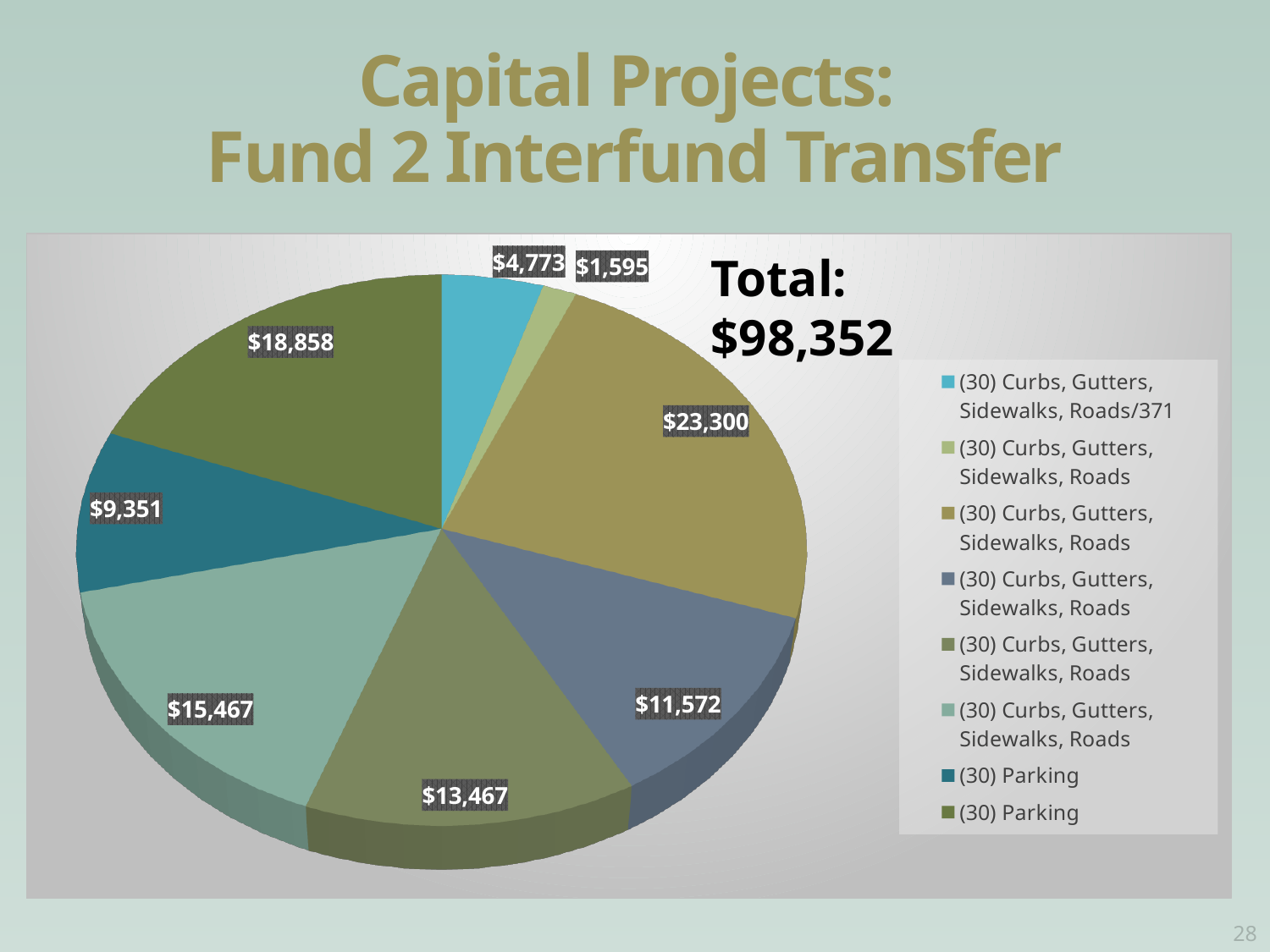
What kind of chart is shown on the slide? pie chart Which is larger, the slice labelled $18,858 or the slice labelled $15,467? $18,858 How many entries does the legend of the pie chart list? 8 How many slices does the pie chart have? 8 Which is larger, the slice labelled $11,572 or the slice labelled $13,467? $13,467 What is the difference between the $23,300 slice and the $18,858 slice? $4,442 What total is printed next to the pie chart? $98,352 What is the value of the smallest slice in the pie chart? $1,595 What is the difference between the $9,351 slice and the $4,773 slice? $4,578 What is the value for (30) Curbs, Gutters, Sidewalks, Roads/371? $4,773 What is the difference between the $15,467 slice and the $13,467 slice? $2,000 What is the value of the largest slice in the pie chart? $23,300